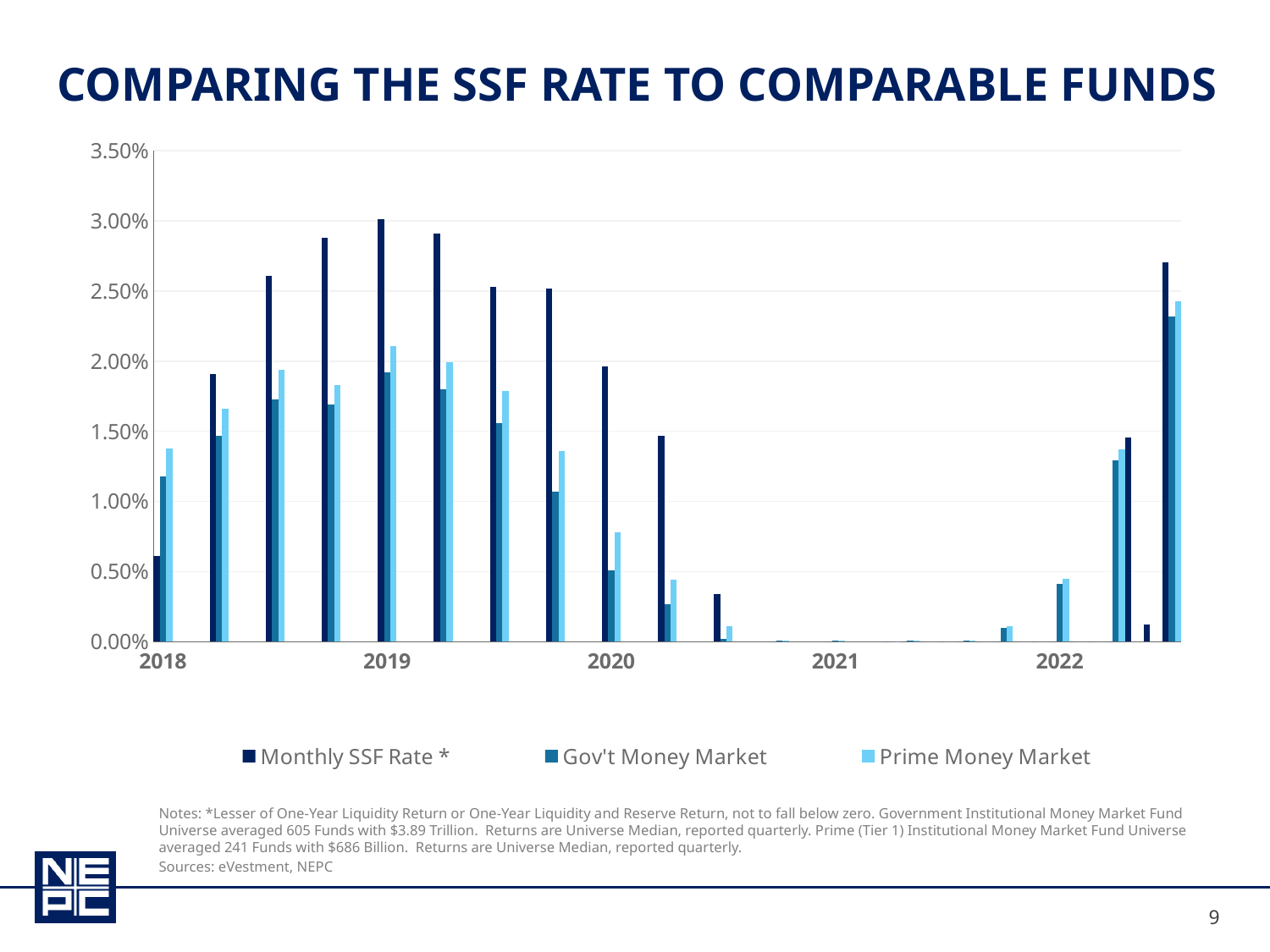
Is the Monthly SSF Rate value at the 2019 label greater or less than 2.50%? greater Is the Prime Money Market value at the 2018 label greater or less than 1.00%? greater How many series does the legend list? 3 At the 2018 label, which is larger: the Gov't Money Market or the Prime Money Market value? Prime Money Market At the 2019 label, which is larger: the Monthly SSF Rate or the Gov't Money Market value? Monthly SSF Rate What kind of chart is shown on the slide? Bar chart Is the Monthly SSF Rate value for the last group of bars on the right greater or less than 2.50%? greater Does the Monthly SSF Rate rise or fall between the 2019 label and the 2021 label? fall What is the title of the slide's chart? COMPARING THE SSF RATE TO COMPARABLE FUNDS How many year labels are shown on the x axis? 5